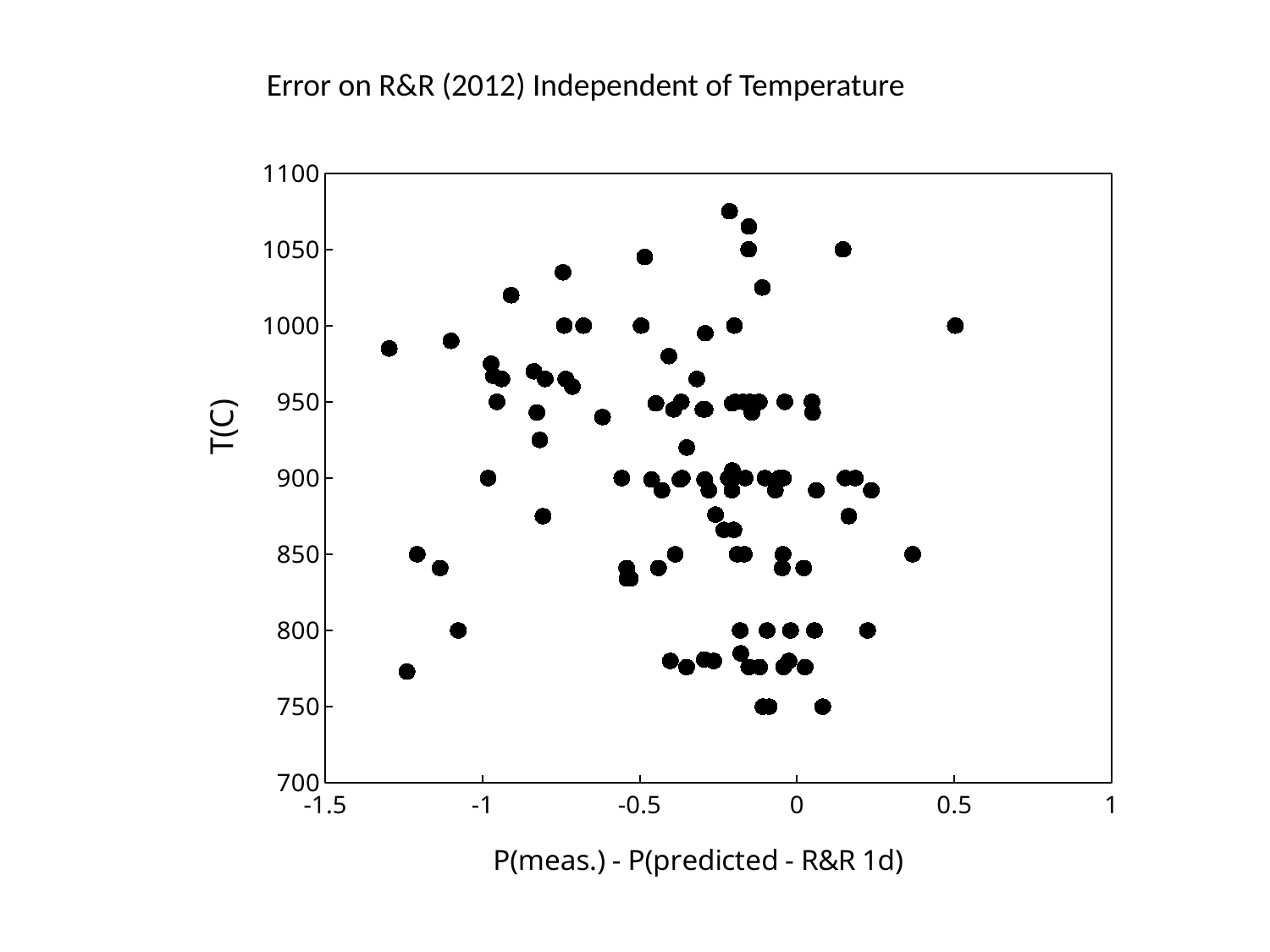
Is the highest temperature plotted greater or less than 1050? greater Is the lowest temperature plotted greater or less than 800? less Is the x value of the highest point greater or less than 0? less What kind of chart is shown on the slide? scatter plot What is the label of the y axis? T(C) What is the title of the chart? Error on R&R (2012) Independent of Temperature